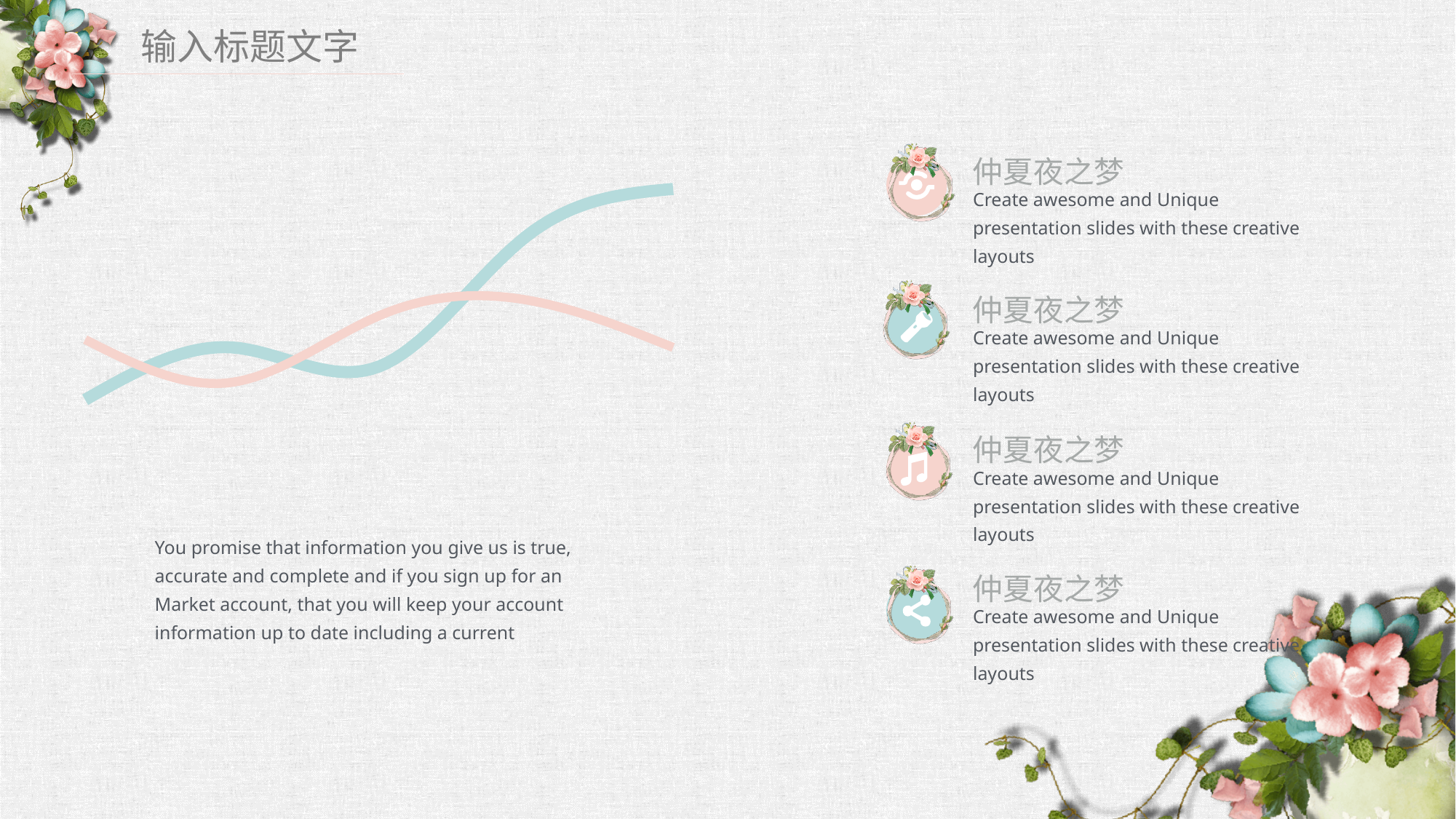
What two colours are the lines in the chart? blue and pink Does the chart display a legend? No Does the blue line in the chart rise or fall overall from left to right? rise Which line is higher at the right end of the chart, the blue line or the pink line? the blue line What kind of chart is shown on the left side of the slide? line chart How many lines are plotted in the chart? 2 Which line is higher at the left end of the chart, the blue line or the pink line? the pink line